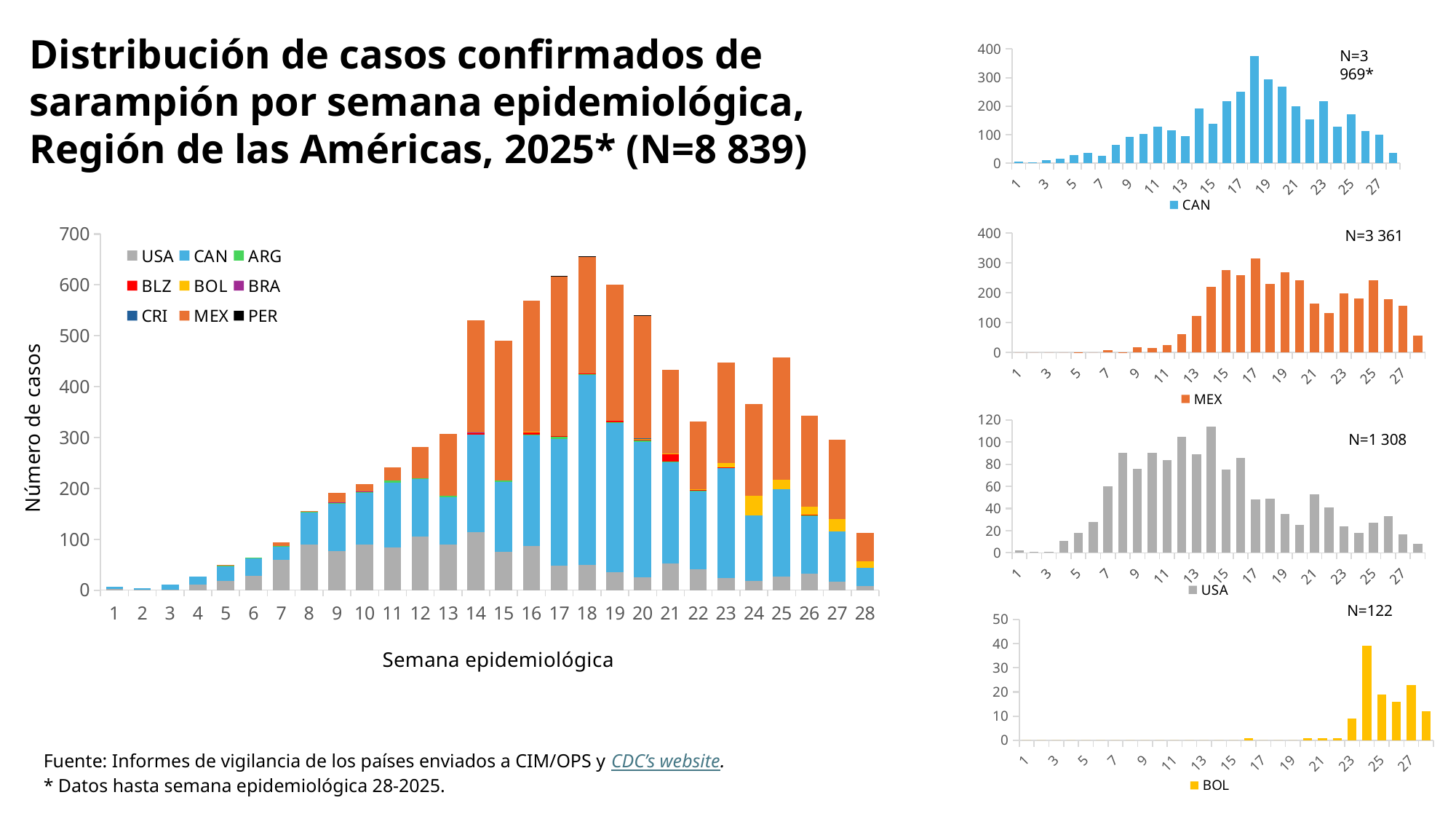
In the large chart on the left, is the total for week 18 greater or less than 600? greater In the MEX chart on the right, is the value for week 17 greater or less than 300? greater In the large chart on the left, which is larger, the total for week 14 or the total for week 18? week 18 What kind of chart is the large chart on the left of the slide? stacked bar chart How many epidemiological weeks are shown on the x axis of the large chart on the left? 28 What N value is printed on the USA chart on the right? N=1 308 In the CAN chart on the right, which week has the highest bar? 18 In the BOL chart on the right, which week has the highest bar? 24 In the large chart on the left, do the totals rise or fall from week 1 to week 18? rise In the large chart on the left, is the total for week 28 greater or less than 200? less In the large chart on the left, which epidemiological week has the tallest stacked bar? 18 How many series does the legend of the large chart on the left list? 9